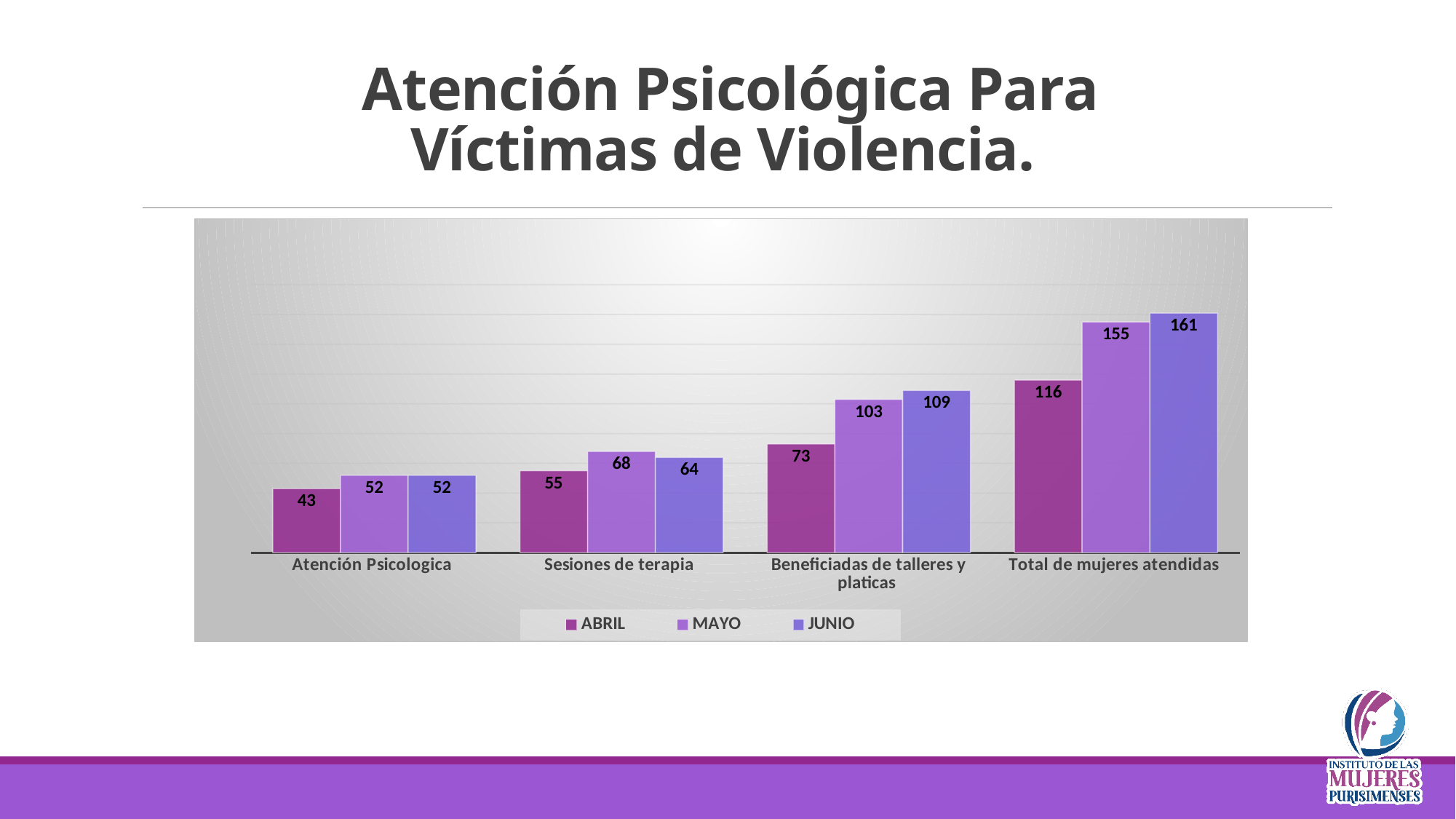
How many series does the legend list? 3 Which category has the lowest value for the MAYO series? Atención Psicologica What is the value for ABRIL in the Atención Psicologica category? 43 Which category has the highest value for the ABRIL series? Total de mujeres atendidas How many categories are shown on the x axis? 4 What kind of chart is shown on the slide? Bar chart Do the ABRIL values rise or fall from left to right across the categories? Rise What is the value for JUNIO in the Sesiones de terapia category? 64 Which is larger in the Sesiones de terapia category, the MAYO value or the JUNIO value? MAYO What is the difference between the JUNIO and ABRIL values for Total de mujeres atendidas? 45 What is the value for MAYO in the Beneficiadas de talleres y platicas category? 103 What is the value for JUNIO in the Total de mujeres atendidas category? 161